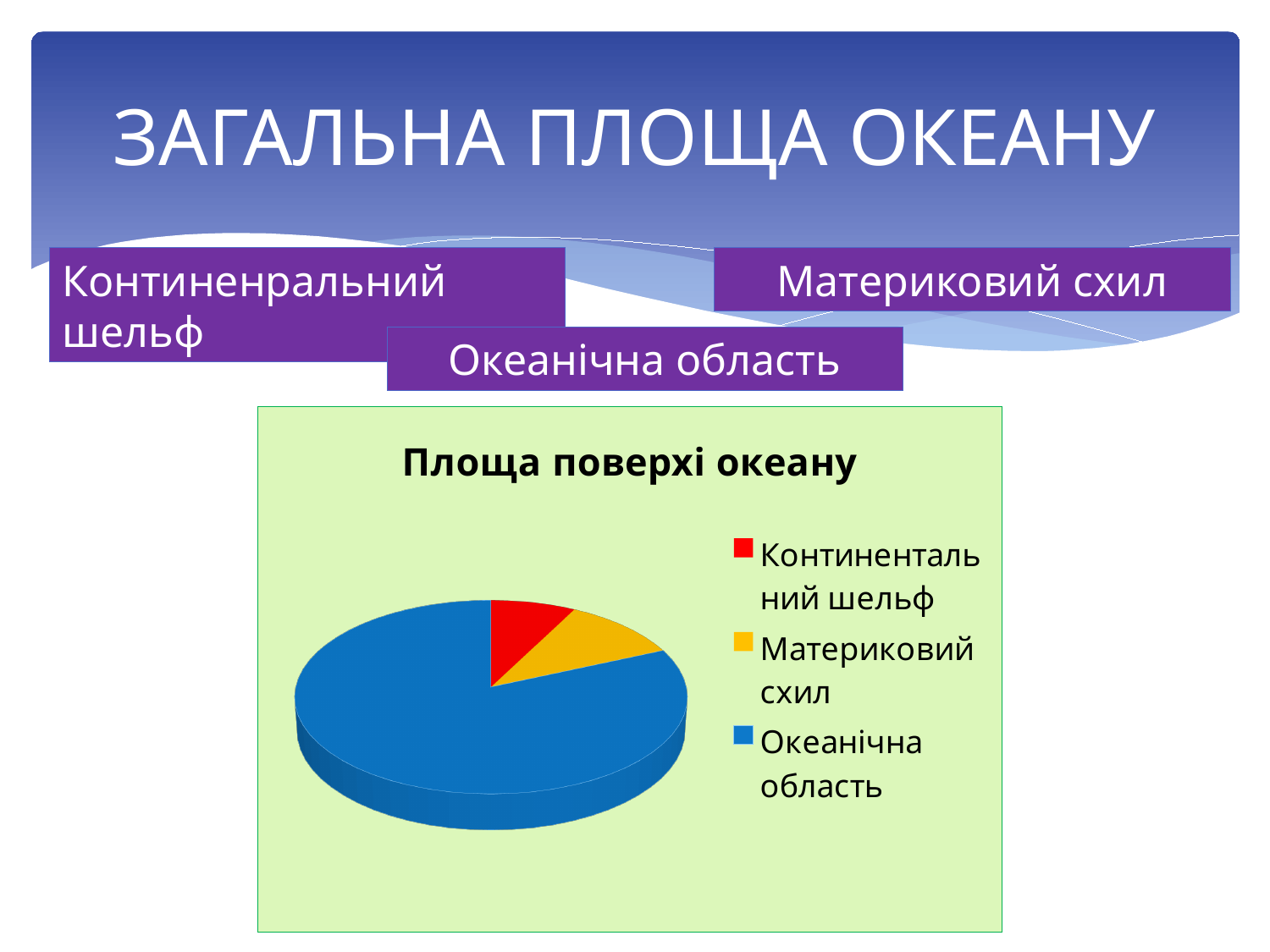
What is the title of the pie chart? Площа поверхі океану How many slices does the pie chart have? 3 Which is larger in the pie chart: Океанічна область or Континентальний шельф? Океанічна область What kind of chart is shown on the slide? pie chart What colour represents Океанічна область in the pie chart? blue Which category has the largest slice in the pie chart? Океанічна область How many entries does the legend of the pie chart list? 3 Which is larger in the pie chart: Океанічна область or Материковий схил? Океанічна область